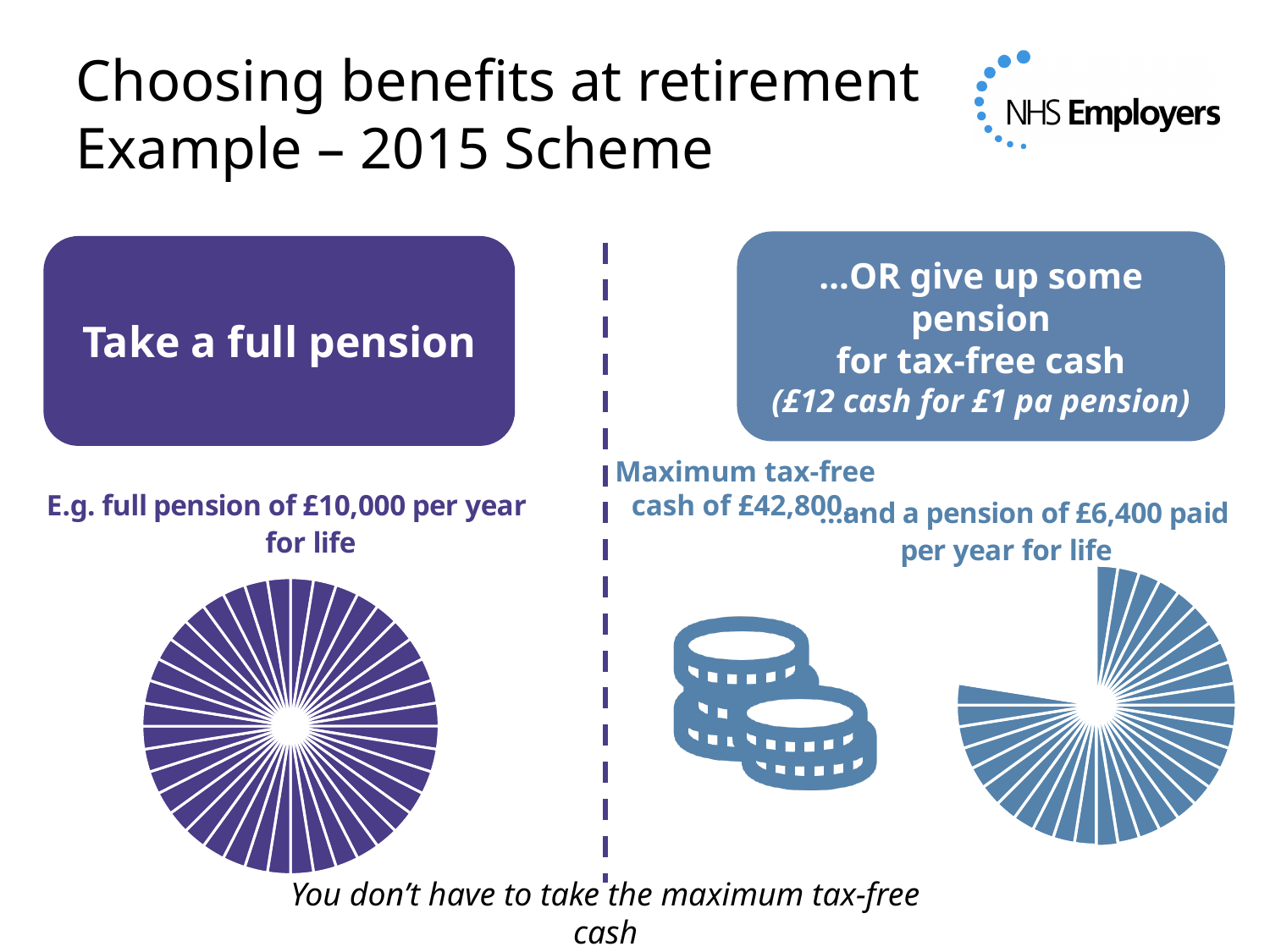
What annual pension amount does the left pie chart represent? £10,000 per year What colour is the left pie chart? Purple What annual pension amount does the right pie chart (under 'and a pension of...') represent? £6,400 What kind of chart is shown under 'Take a full pension' on the left of the slide? Pie chart What is the difference between the full pension of £10,000 and the reduced pension of £6,400? £3,600 What is the maximum tax-free cash shown on the right side of the slide? £42,800 How much tax-free cash is given for each £1 per year of pension given up? £12 Which is larger: the full pension on the left or the reduced pension on the right? The full pension on the left Which of the two pie charts has a wedge missing from it? The right pie chart